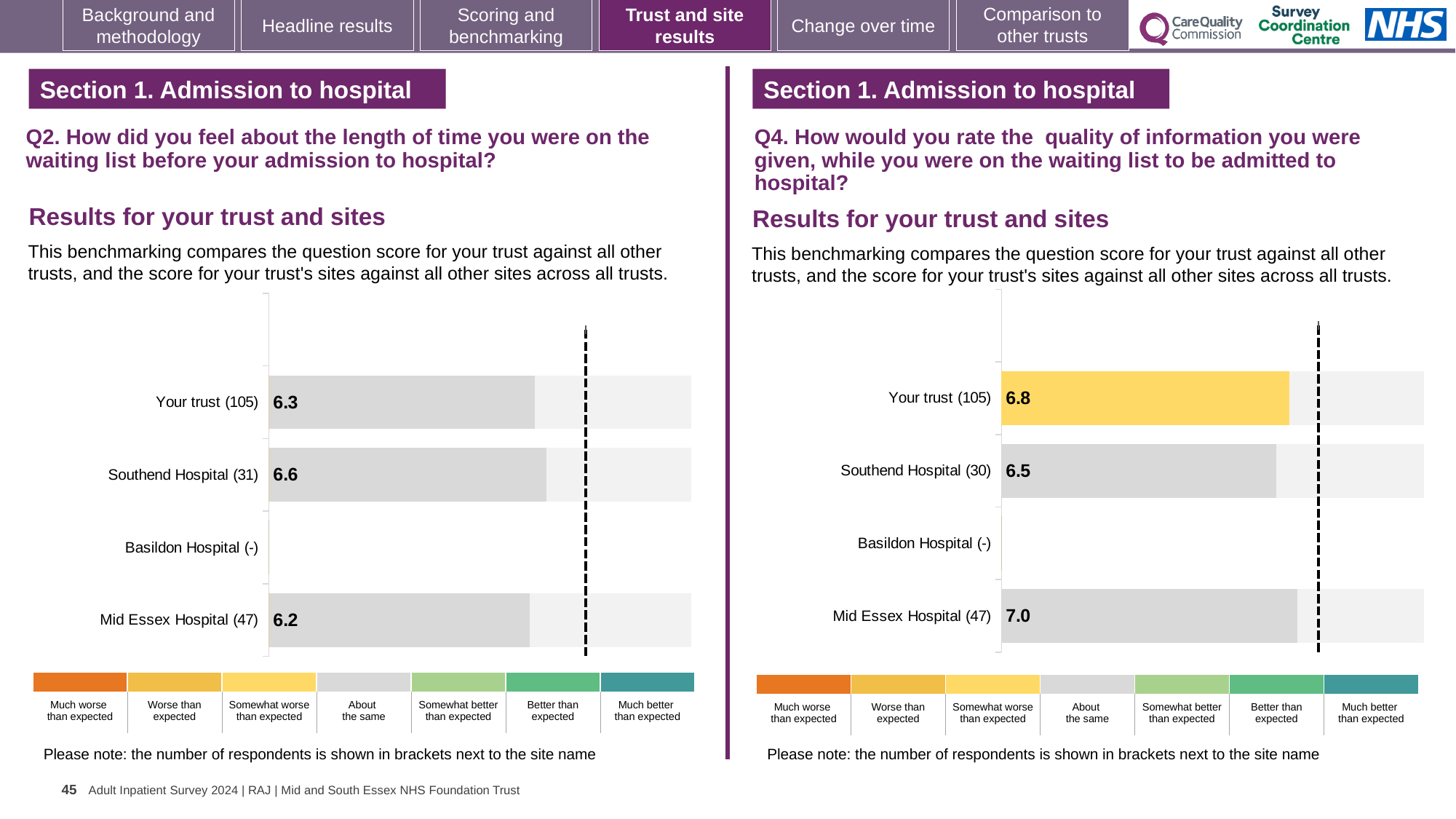
How many rows (sites or trust) are listed on the y axis of the Q2 chart on the left? 4 What type of chart is used for the Q4 results on the right? Bar chart In the Q2 chart on the left, what is the difference between the Southend Hospital score and the Mid Essex Hospital score? 0.4 In the Q4 chart on the right, what is the difference between the Mid Essex Hospital score and the Southend Hospital score? 0.5 In the Q2 chart on the left, what is the score for Your trust? 6.3 In the Q4 chart on the right, which site or trust has the highest score? Mid Essex Hospital In the Q4 chart on the right, what is the score for Mid Essex Hospital? 7.0 In the Q4 chart on the right, what is the score for Your trust? 6.8 In the Q2 chart on the left, how many respondents are shown in brackets for Mid Essex Hospital? 47 In the Q2 chart on the left, which site or trust has the lowest score? Mid Essex Hospital In the Q2 chart on the left, what is the score for Southend Hospital? 6.6 In the Q4 chart on the right, which has the larger score, Your trust or Southend Hospital? Your trust